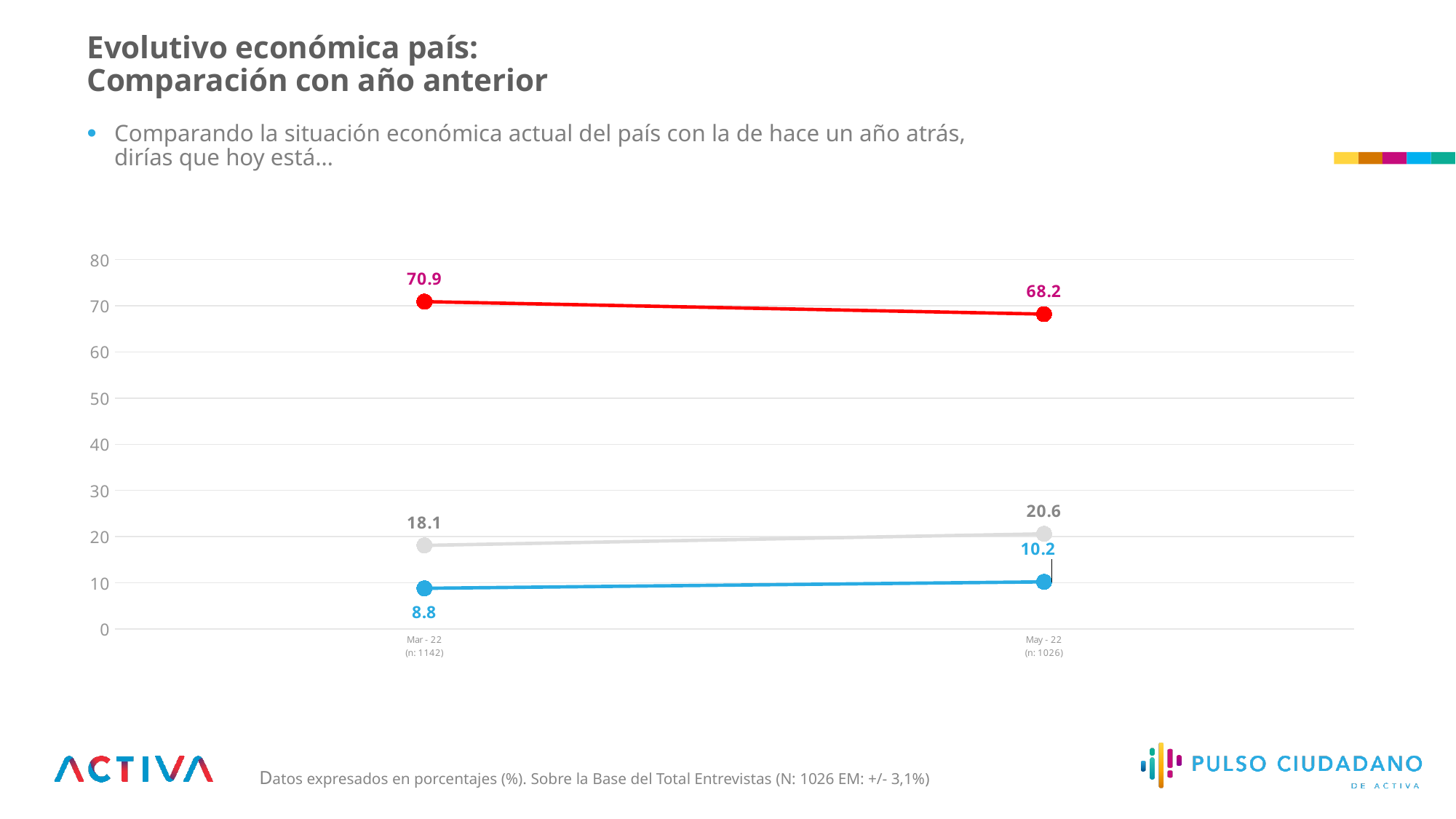
By how much did the red line change from Mar - 22 to May - 22? 2.7 What is the value of the blue line at Mar - 22? 8.8 What kind of chart is shown on the slide? Line chart What is the value of the red line at May - 22? 68.2 Does the red line rise or fall from Mar - 22 to May - 22? Fall What is the value of the red line at Mar - 22? 70.9 Which line has the highest value at May - 22? The red line What is the value of the grey line at May - 22? 20.6 What is the difference between the grey line and the blue line at Mar - 22? 9.3 What is the value of the blue line at May - 22? 10.2 How many time points are shown on the x axis? 2 Which line has the lowest value at Mar - 22? The blue line